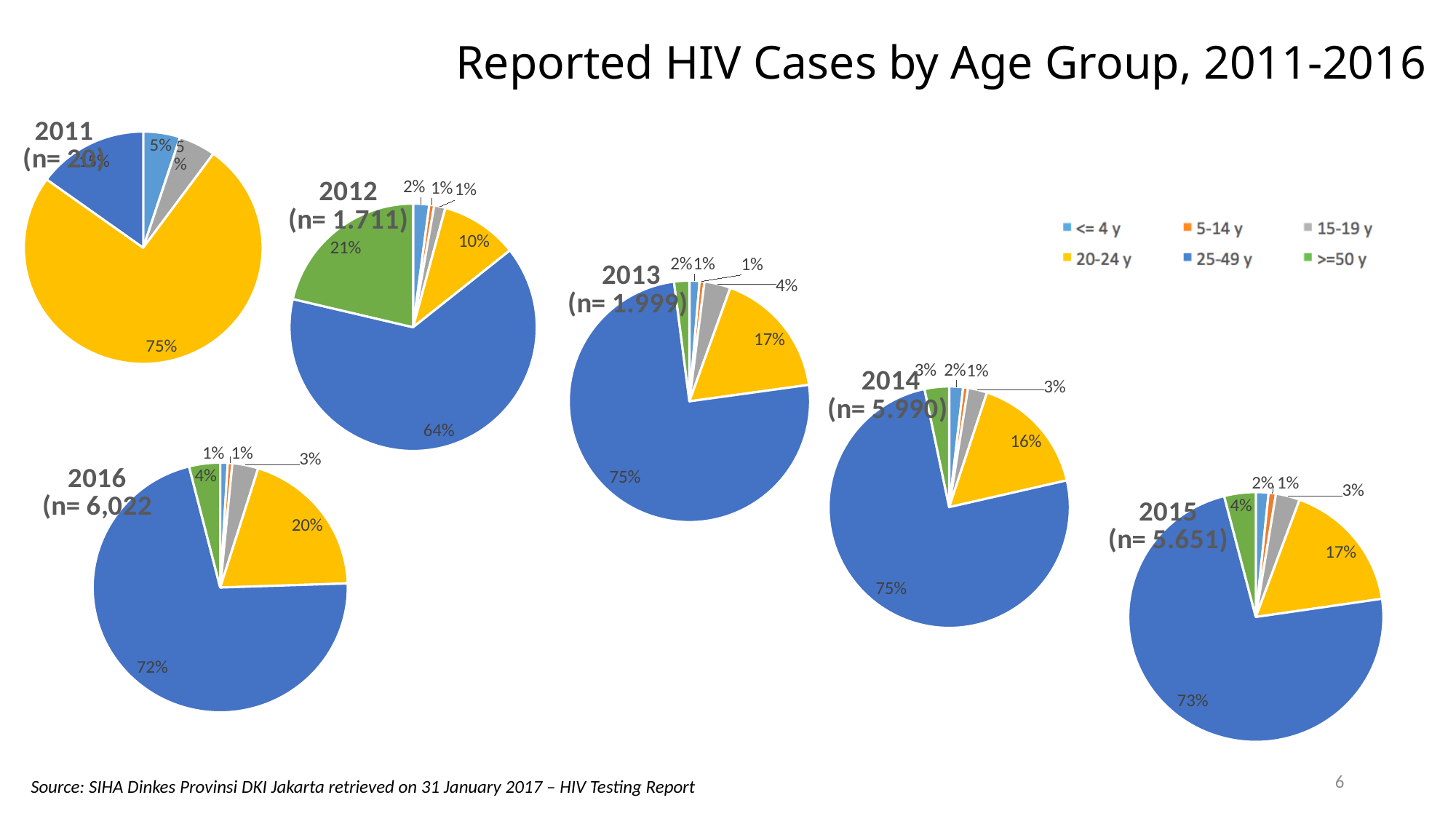
In the 2014 pie chart, what share of cases is in the 25-49 y age group? 75% What type of charts are shown on the slide? Pie charts In the 2011 pie chart, which age group has the largest share? 20-24 y In the 2016 pie chart, what share of cases is in the 20-24 y age group? 20% How many pie charts are on the slide? 6 In the 2012 pie chart, what share of cases is in the >=50 y age group? 21% What is the difference between the 20-24 y share in 2016 and in 2014? 4% In the 2016 pie chart, which age group has the largest share? 25-49 y In the 2013 pie chart, what share of cases is in the 20-24 y age group? 17% In the 2015 pie chart, what share of cases is in the 25-49 y age group? 73% How many age groups does the legend list? 6 In the 2012 pie chart, what share of cases is in the 25-49 y age group? 64%